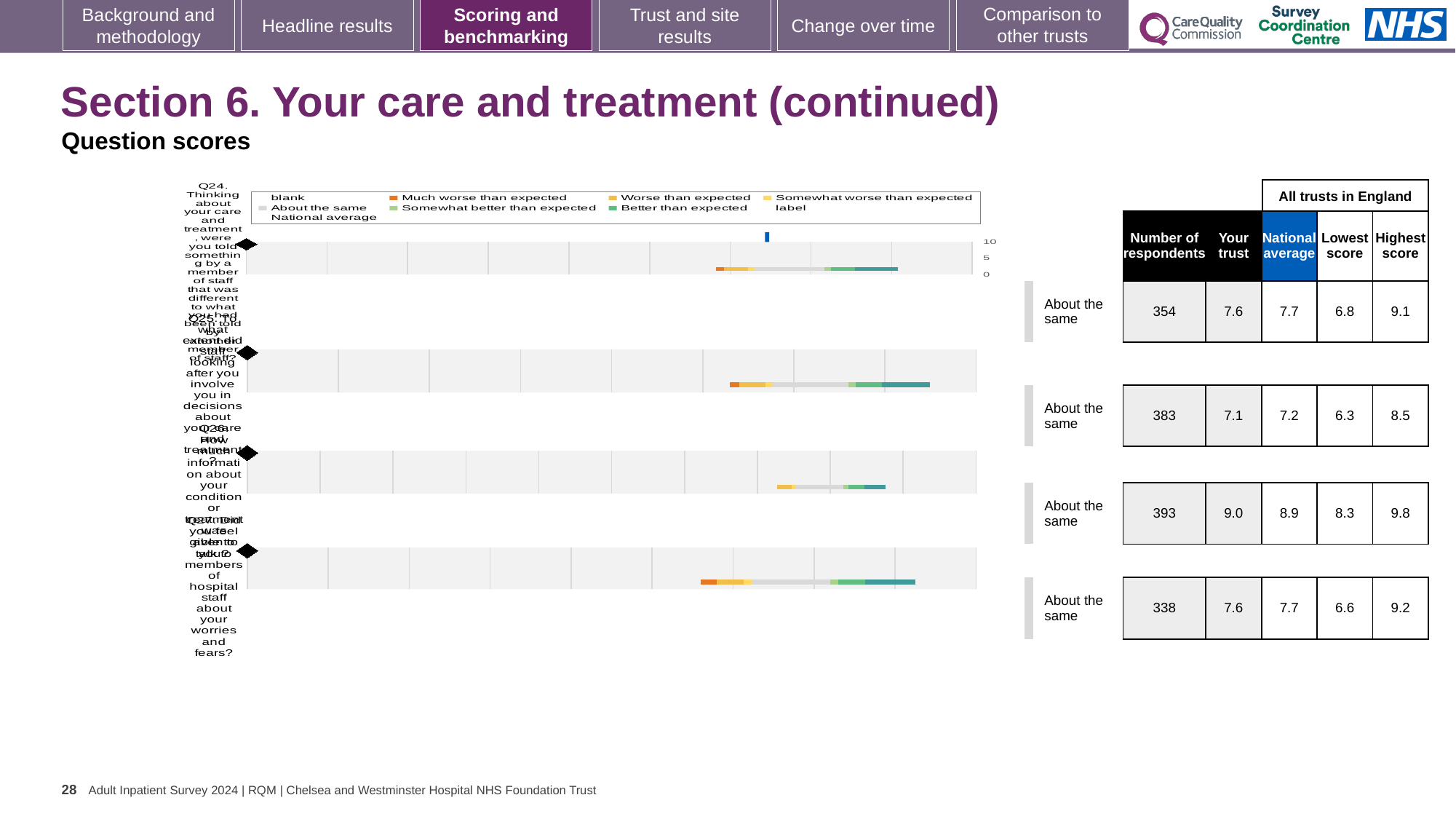
Which legend entry is shown in grey in the chart? About the same What is the difference between the highest score and the lowest score for Q26 in the table beside the chart? 1.5 In the table beside the chart, what is the 'Your trust' score for Q24? 7.6 Which of the four questions has the highest 'Your trust' score in the table beside the chart? Q26 Which legend entry is shown in orange in the chart? Much worse than expected In the table beside the chart, what is the highest score for Q27? 9.2 Which of the four questions has the lowest 'Your trust' score in the table beside the chart? Q25 How many question bars are plotted in the chart? 4 In the table beside the chart, what is the national average for Q25? 7.2 How many entries does the chart legend list? 9 In the table beside the chart, how many respondents answered Q26? 393 What kind of chart is shown on the slide? bar chart